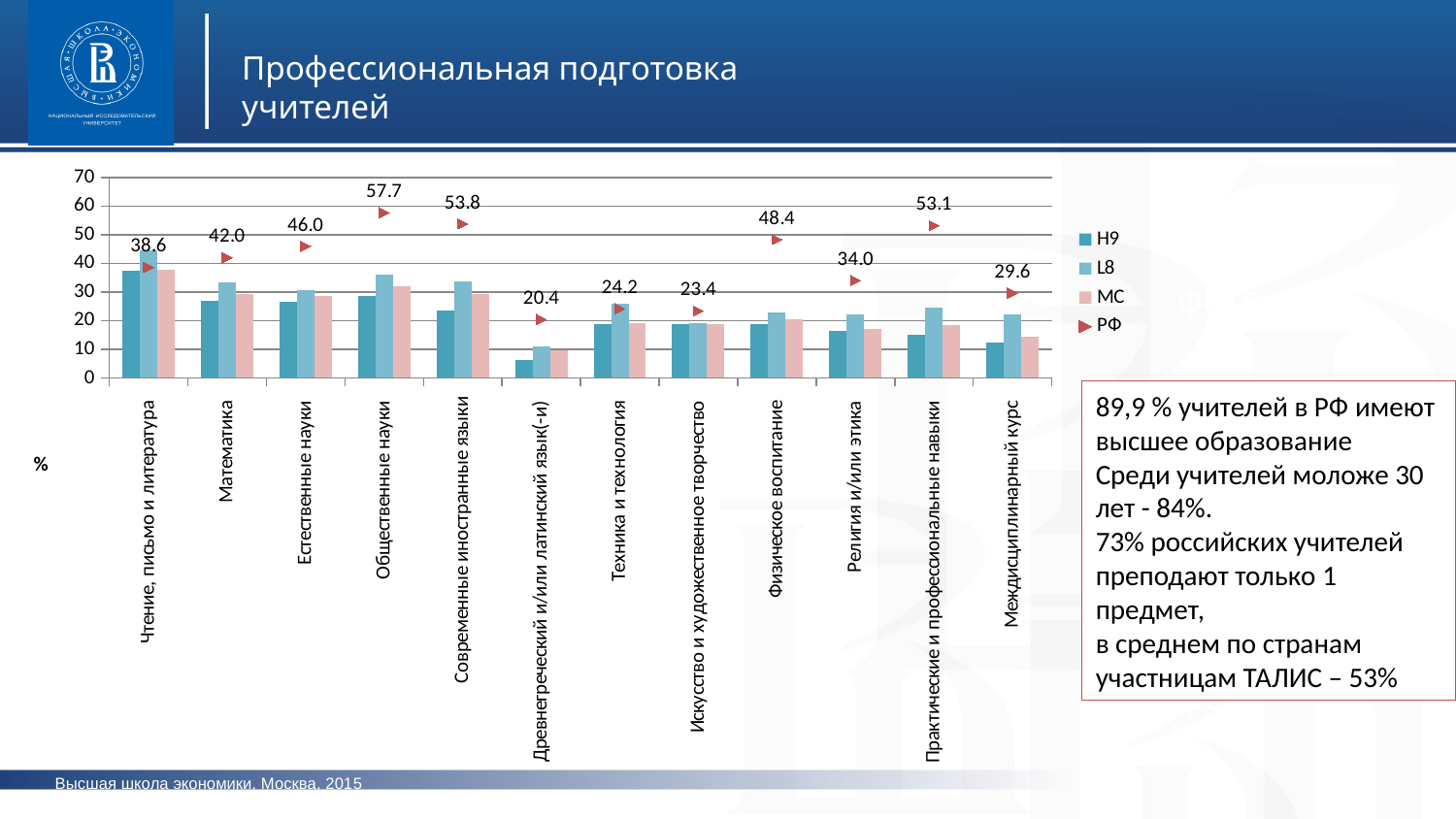
How many categories are shown on the x axis of the chart? 12 What is the РФ value for Междисциплинарный курс? 29.6 Which category has the lowest РФ value? Древнегреческий и/или латинский язык(-и) What kind of chart is shown on the slide? bar chart How many series does the legend list? 4 What is the РФ value for Общественные науки? 57.7 Is the Н9 value for Чтение, письмо и литература greater or less than 30? greater Is the L8 value for Древнегреческий и/или латинский язык(-и) greater or less than 20? less Which has a larger РФ value: Физическое воспитание or Религия и/или этика? Физическое воспитание Which category has the highest РФ value? Общественные науки What is the difference between the РФ values for Общественные науки and Древнегреческий и/или латинский язык(-и)? 37.3 What is the РФ value for Математика? 42.0